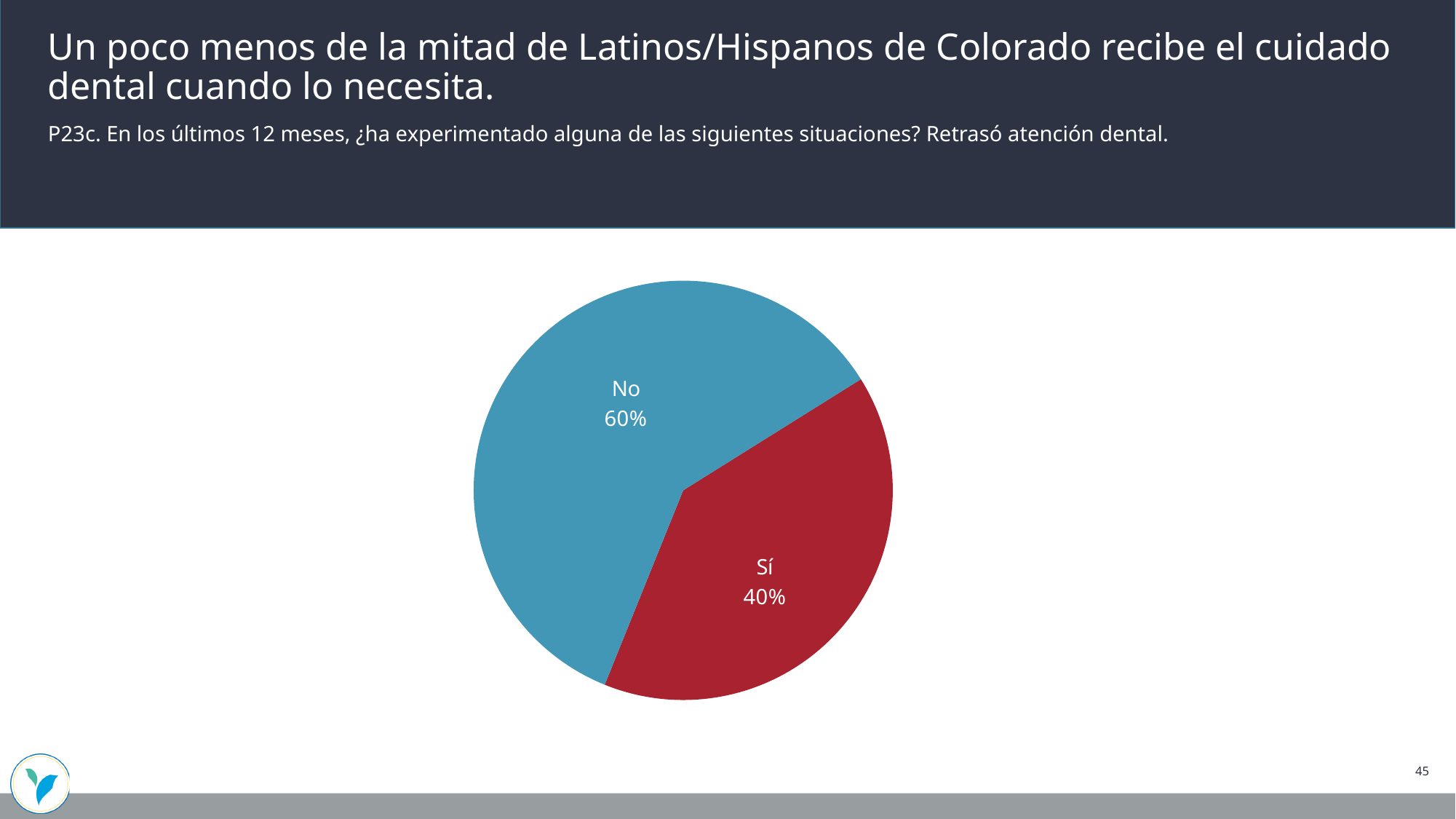
What is the total of the two slices shown in the pie chart? 100% How many slices does the pie chart have? 2 Which slice of the pie is the smallest? Sí What colour is the "No" slice? blue Which slice of the pie is the largest? No What percentage of respondents answered "No"? 60% What is the difference in percentage points between the "No" and "Sí" slices? 20 What percentage of respondents answered "Sí"? 40% What colour is the "Sí" slice? red Which is larger, the "Sí" slice or the "No" slice? No What share of the pie does the "Sí" slice represent? 40% What kind of chart is shown on the slide? pie chart